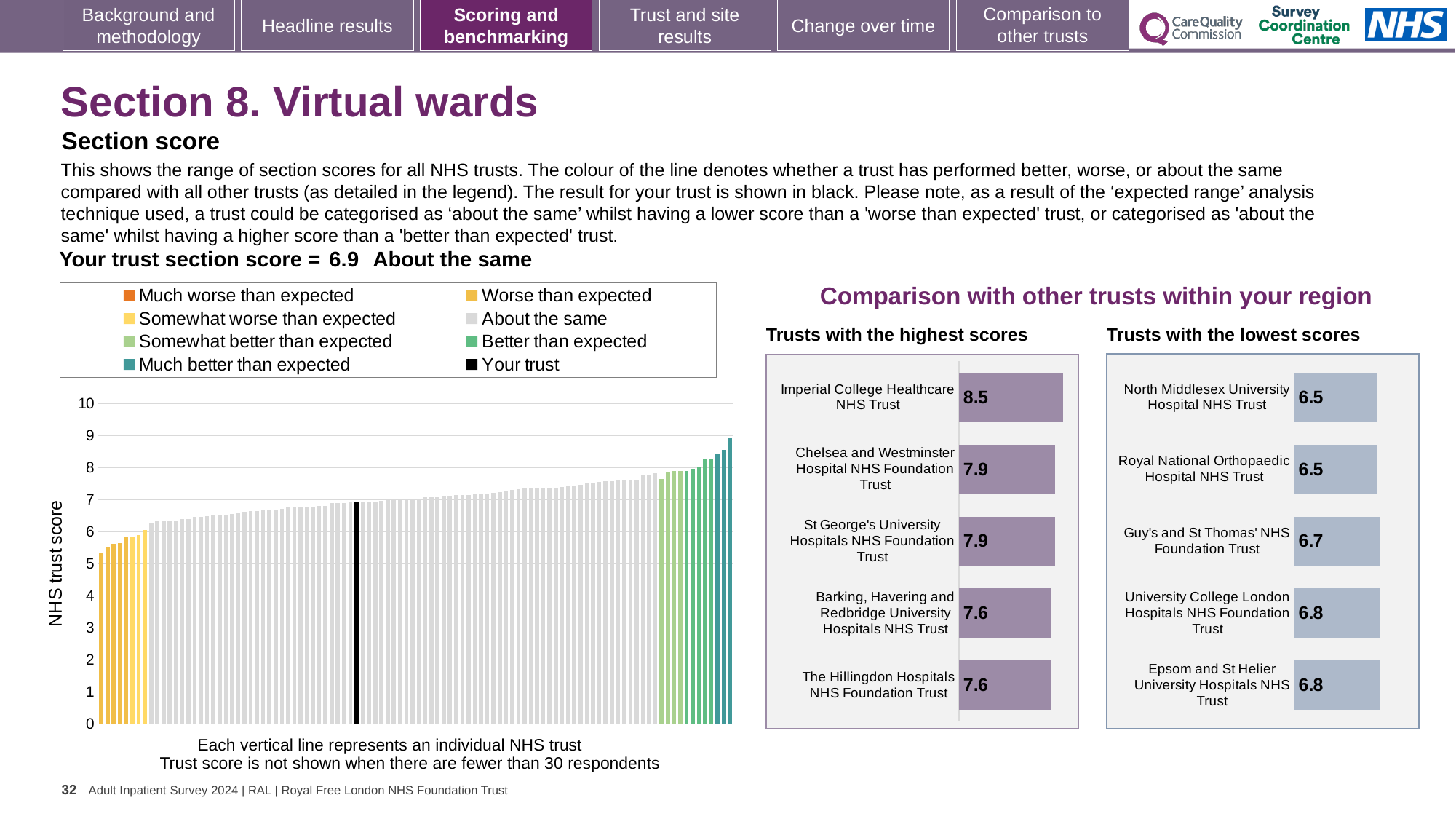
In the 'Trusts with the highest scores' chart, what is the score for Imperial College Healthcare NHS Trust? 8.5 How many entries does the legend of the main NHS trust score chart list? 8 In the main NHS trust score chart, what colour is the bar for your trust? Black In the 'Trusts with the lowest scores' chart, which has the larger score: Guy's and St Thomas' NHS Foundation Trust or University College London Hospitals NHS Foundation Trust? University College London Hospitals NHS Foundation Trust In the main NHS trust score chart, what is the section score for your trust? 6.9 In the main NHS trust score chart, do the trust scores rise or fall from left to right? Rise How many trusts are shown in the 'Trusts with the highest scores' chart? 5 In the 'Trusts with the highest scores' chart, which trust has the highest score? Imperial College Healthcare NHS Trust In the 'Trusts with the lowest scores' chart, what is the score for North Middlesex University Hospital NHS Trust? 6.5 In the 'Trusts with the highest scores' chart, what is the difference between the scores of Imperial College Healthcare NHS Trust and The Hillingdon Hospitals NHS Foundation Trust? 0.9 In the 'Trusts with the lowest scores' chart, what is the difference between the scores of Epsom and St Helier University Hospitals NHS Trust and North Middlesex University Hospital NHS Trust? 0.3 What kind of chart is the main NHS trust score chart on the left? Bar chart